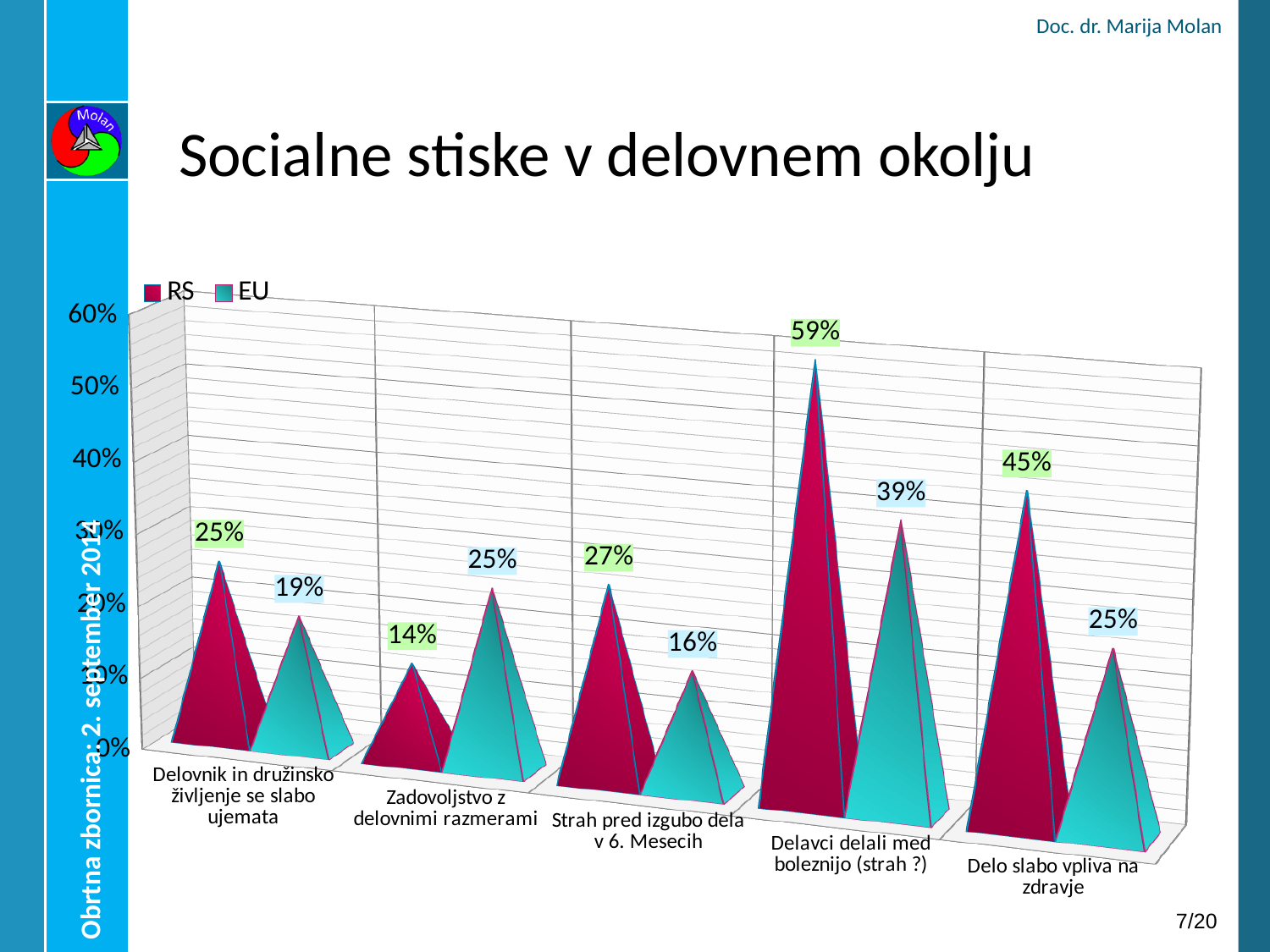
Which category has the lowest RS value? Zadovoljstvo z delovnimi razmerami What is the difference between the RS and EU values for "Delavci delali med boleznijo (strah ?)"? 20% What is the EU value for "Zadovoljstvo z delovnimi razmerami"? 25% Which category has the highest RS value? Delavci delali med boleznijo (strah ?) What kind of chart is shown on the slide? bar chart What is the title of the slide containing the chart? Socialne stiske v delovnem okolju Which is larger for "Zadovoljstvo z delovnimi razmerami", the RS value or the EU value? EU What is the EU value for "Strah pred izgubo dela v 6. Mesecih"? 16% How many series does the legend list? 2 What is the RS value for "Delavci delali med boleznijo (strah ?)"? 59% What is the RS value for "Delo slabo vpliva na zdravje"? 45% How many categories are shown on the x axis? 5